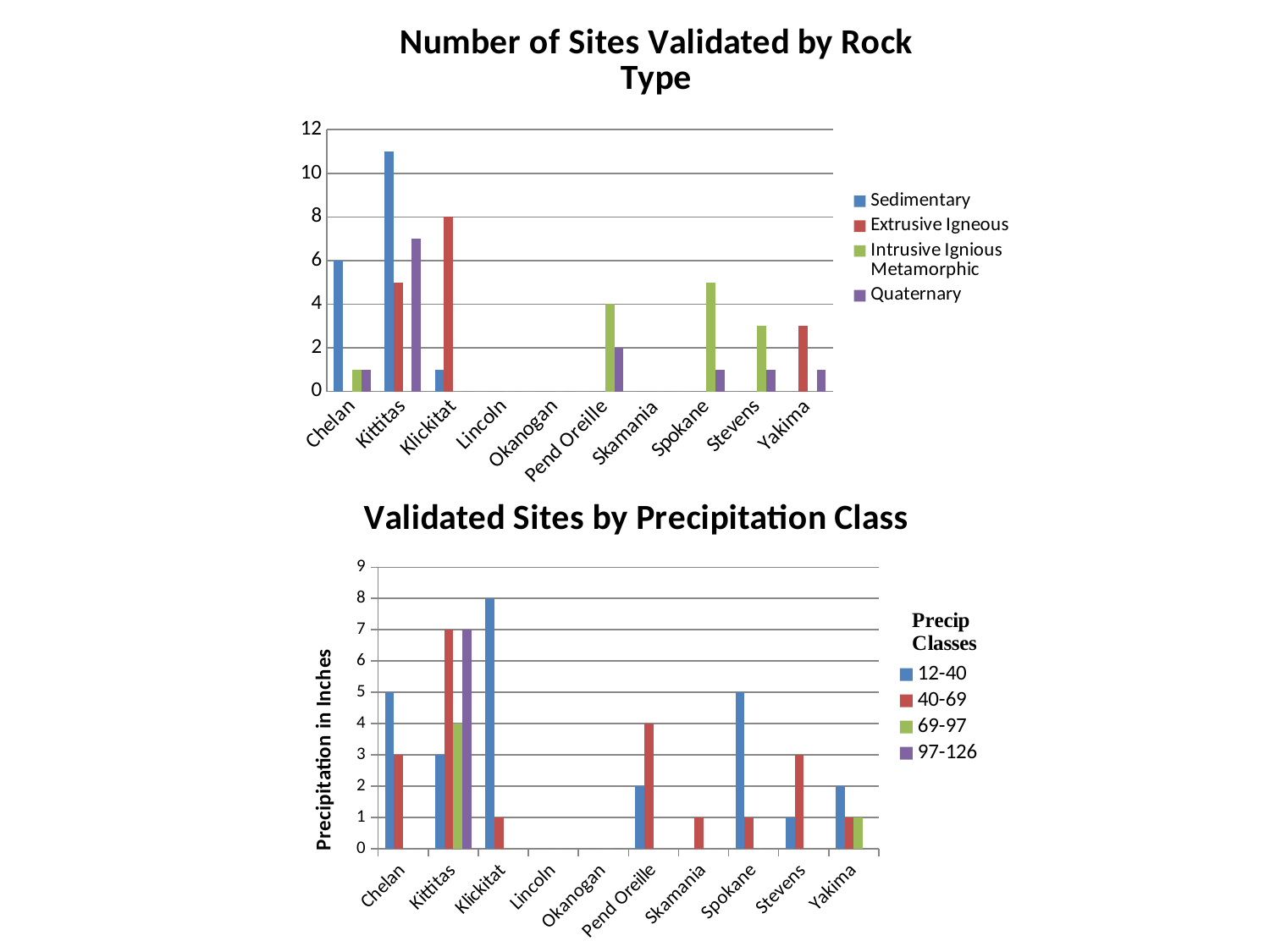
In the 'Number of Sites Validated by Rock Type' chart, what is the Sedimentary value for Chelan? 6 In the 'Validated Sites by Precipitation Class' chart, which county has the highest 12-40 bar? Klickitat In the 'Number of Sites Validated by Rock Type' chart, how many series does the legend list? 4 In the 'Validated Sites by Precipitation Class' chart, what is the 12-40 value for Klickitat? 8 In the 'Number of Sites Validated by Rock Type' chart, which county has the highest Sedimentary bar? Kittitas In the 'Number of Sites Validated by Rock Type' chart, is the Sedimentary value for Kittitas greater or less than 10? greater In the 'Validated Sites by Precipitation Class' chart, which is larger for Pend Oreille: the 12-40 value or the 40-69 value? 40-69 What type of chart is 'Validated Sites by Precipitation Class'? bar chart In the 'Validated Sites by Precipitation Class' chart, what is the difference between the 12-40 value for Chelan and the 40-69 value for Chelan? 2 In the 'Validated Sites by Precipitation Class' chart, what is the 40-69 value for Kittitas? 7 In the 'Number of Sites Validated by Rock Type' chart, how many counties are shown on the x axis? 10 In the 'Number of Sites Validated by Rock Type' chart, what is the Extrusive Igneous value for Klickitat? 8